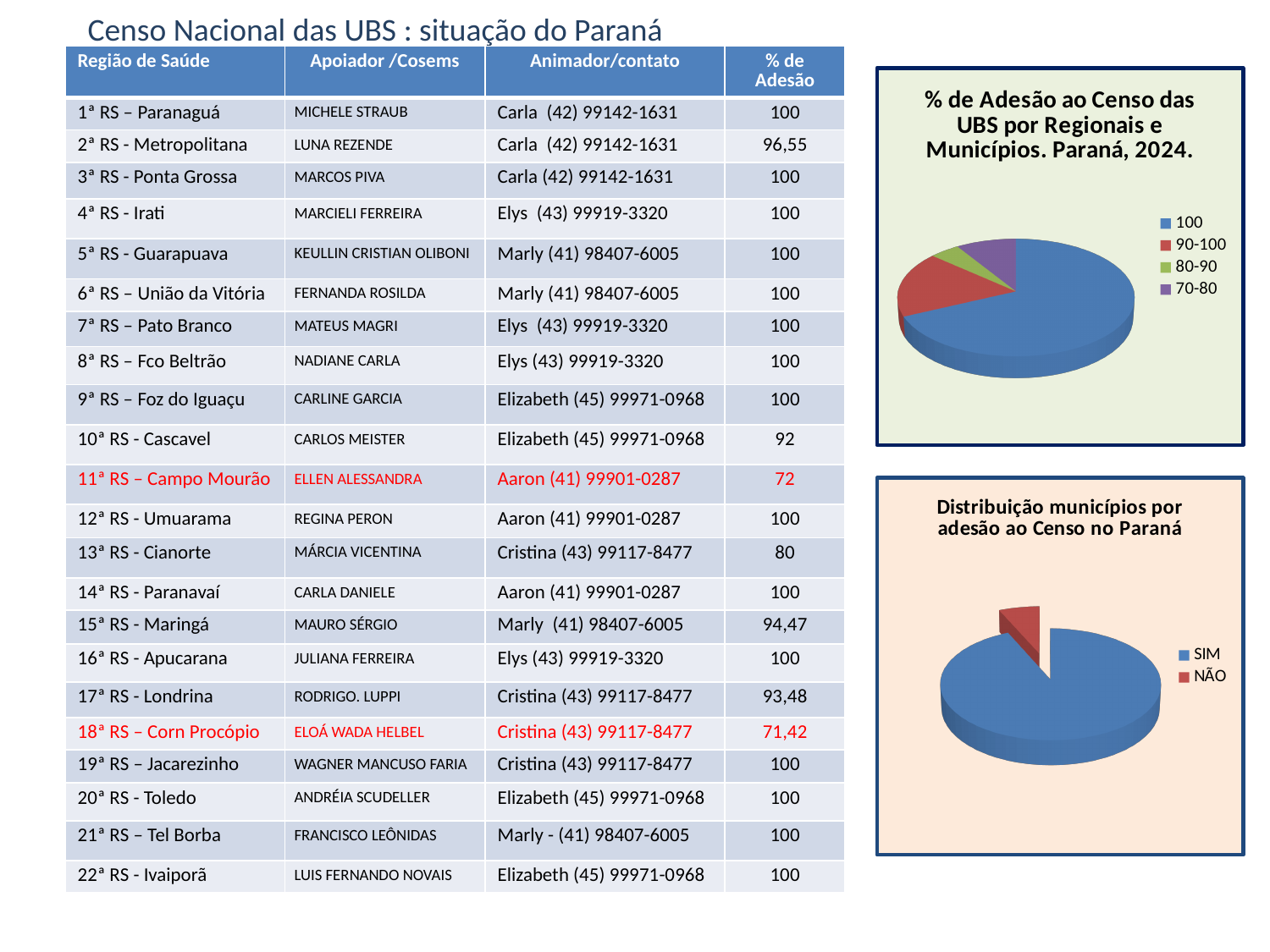
In the chart "Distribuição municípios por adesão ao Censo no Paraná", which category has the largest slice? SIM In the chart "% de Adesão ao Censo das UBS por Regionais e Municípios. Paraná, 2024.", how many categories does the legend list? 4 What kind of chart is the chart titled "Distribuição municípios por adesão ao Censo no Paraná"? Pie chart In the chart "Distribuição municípios por adesão ao Censo no Paraná", what colour is the slice for NÃO? Red In the chart "% de Adesão ao Censo das UBS por Regionais e Municípios. Paraná, 2024.", which slice is larger, 90-100 or 70-80? 90-100 In the chart "Distribuição municípios por adesão ao Censo no Paraná", which category has the smallest slice? NÃO What kind of chart is the chart titled "% de Adesão ao Censo das UBS por Regionais e Municípios. Paraná, 2024."? Pie chart In the chart "Distribuição municípios por adesão ao Censo no Paraná", how many categories does the legend list? 2 In the chart "Distribuição municípios por adesão ao Censo no Paraná", which slice is larger, SIM or NÃO? SIM In the chart "% de Adesão ao Censo das UBS por Regionais e Municípios. Paraná, 2024.", which slice is larger, 100 or 90-100? 100 In the chart "% de Adesão ao Censo das UBS por Regionais e Municípios. Paraná, 2024.", which category has the largest slice? 100 In the chart "% de Adesão ao Censo das UBS por Regionais e Municípios. Paraná, 2024.", what colour is the slice for the category 100? Blue